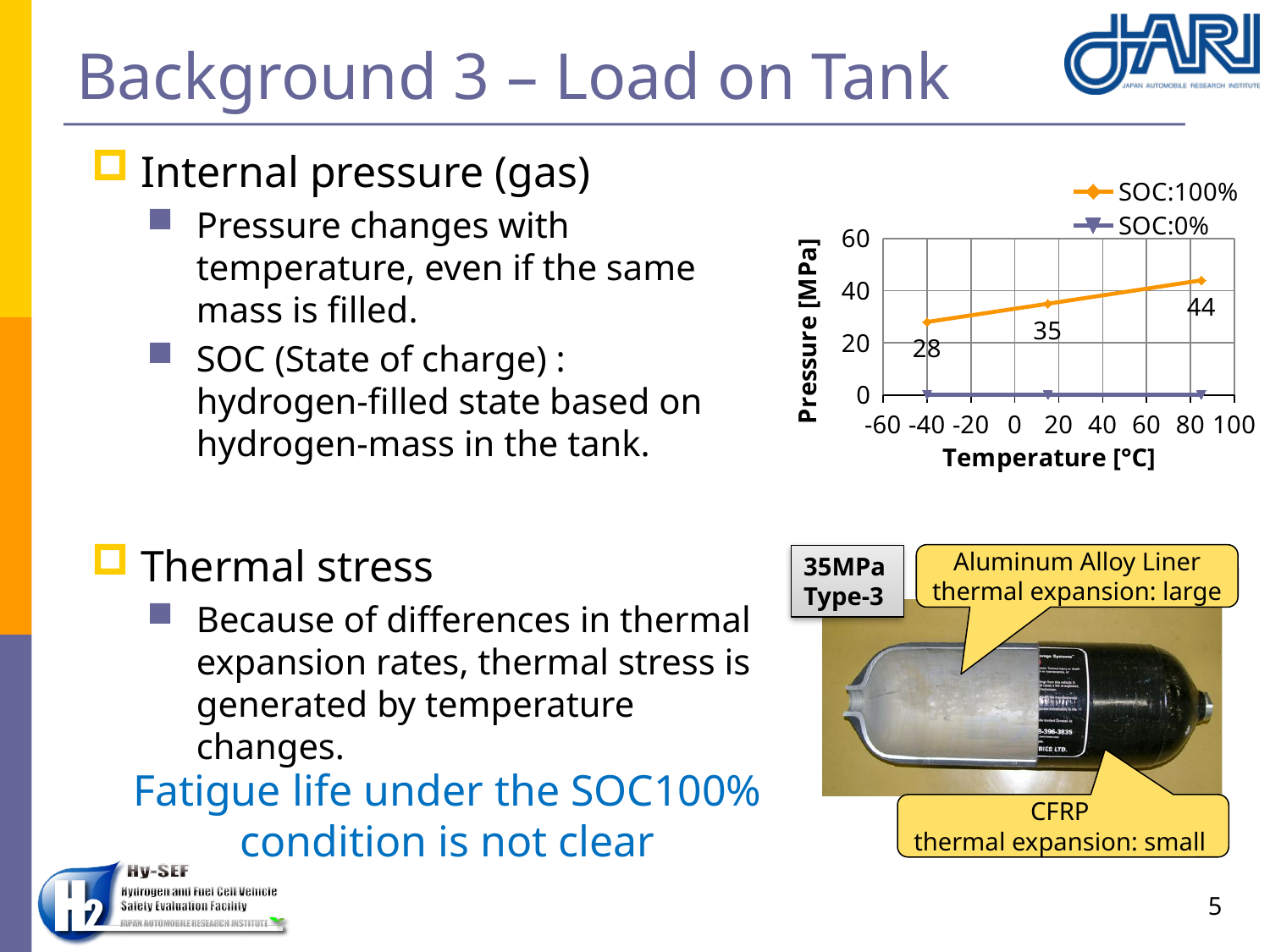
What is the highest labeled pressure value on the SOC:100% line? 44 How many data points are plotted on the SOC:100% line? 3 Does the pressure for SOC:100% rise or fall as temperature increases? rise What type of chart is shown on the slide? line chart Are the pressure values for SOC:0% greater or less than 20 MPa? less What is the lowest labeled pressure value on the SOC:100% line? 28 What are the two series named in the chart legend? SOC:100% and SOC:0% What is the middle labeled pressure value on the SOC:100% line? 35 What is the difference between the highest and lowest labeled values on the SOC:100% line? 16 How many series does the chart legend list? 2 What is the label of the chart's vertical axis? Pressure [MPa] Which series has higher pressure values, SOC:100% or SOC:0%? SOC:100%